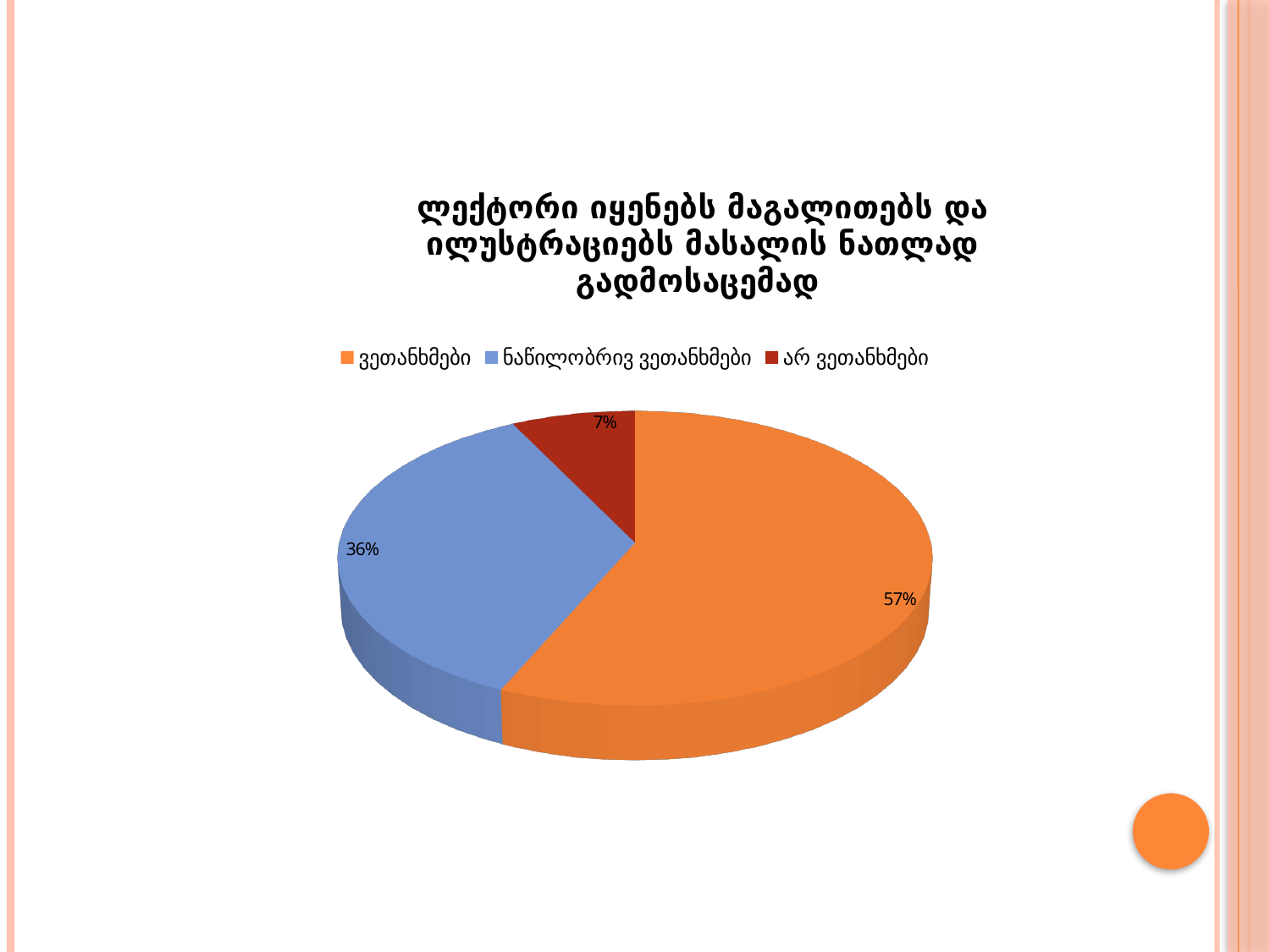
How many entries does the legend list? 3 Which category has the smallest share of the pie? არ ვეთანხმები What is the difference in percentage points between the "ნაწილობრივ ვეთანხმები" and "არ ვეთანხმები" slices? 29 What percentage is shown for the "ნაწილობრივ ვეთანხმები" slice? 36% What colour is the "ვეთანხმები" slice? orange Which is larger, the "ნაწილობრივ ვეთანხმები" slice or the "არ ვეთანხმები" slice? ნაწილობრივ ვეთანხმები What kind of chart is shown on the slide? pie chart How many slices does the pie chart have? 3 What percentage is shown for the "არ ვეთანხმები" slice? 7% Which category has the largest share of the pie? ვეთანხმები What percentage is shown for the "ვეთანხმები" slice? 57% What is the difference in percentage points between the "ვეთანხმები" and "ნაწილობრივ ვეთანხმები" slices? 21